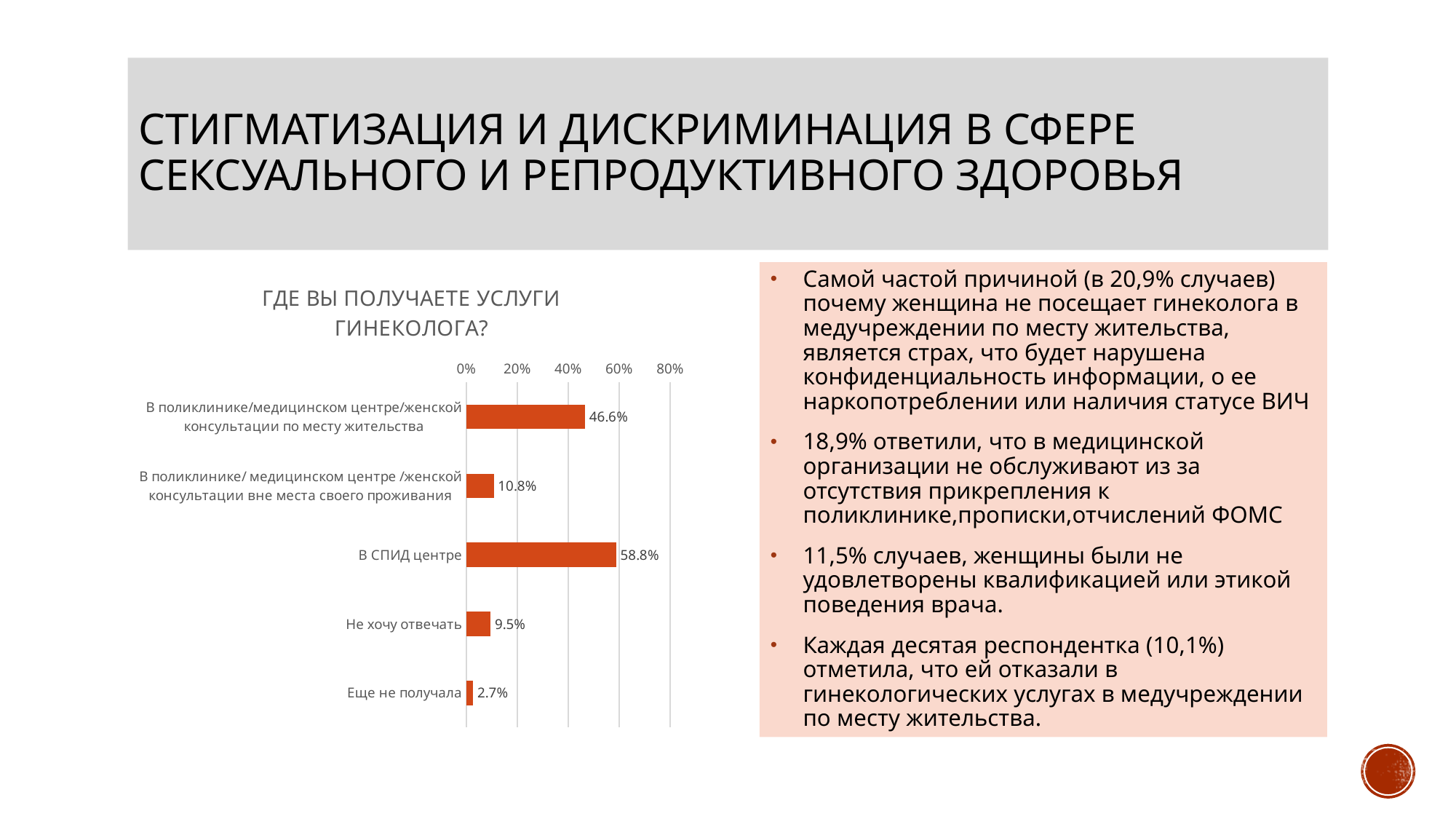
Is the value for 'В СПИД центре' greater or less than 40%? greater Which category has the lowest value? Еще не получала What is the value for 'В СПИД центре'? 58.8% What is the value for 'В поликлинике/медицинском центре/женской консультации по месту жительства'? 46.6% What is the value for 'Еще не получала'? 2.7% How many categories are shown in the chart? 5 Which is larger: the value for 'В поликлинике/ медицинском центре /женской консультации вне места своего проживания' or the value for 'Не хочу отвечать'? В поликлинике/ медицинском центре /женской консультации вне места своего проживания What is the value for 'Не хочу отвечать'? 9.5% What is the title of the chart? ГДЕ ВЫ ПОЛУЧАЕТЕ УСЛУГИ ГИНЕКОЛОГА? What kind of chart is shown on the slide? Bar chart What is the difference between the values for 'В СПИД центре' and 'В поликлинике/медицинском центре/женской консультации по месту жительства'? 12.2% Which category has the highest value? В СПИД центре